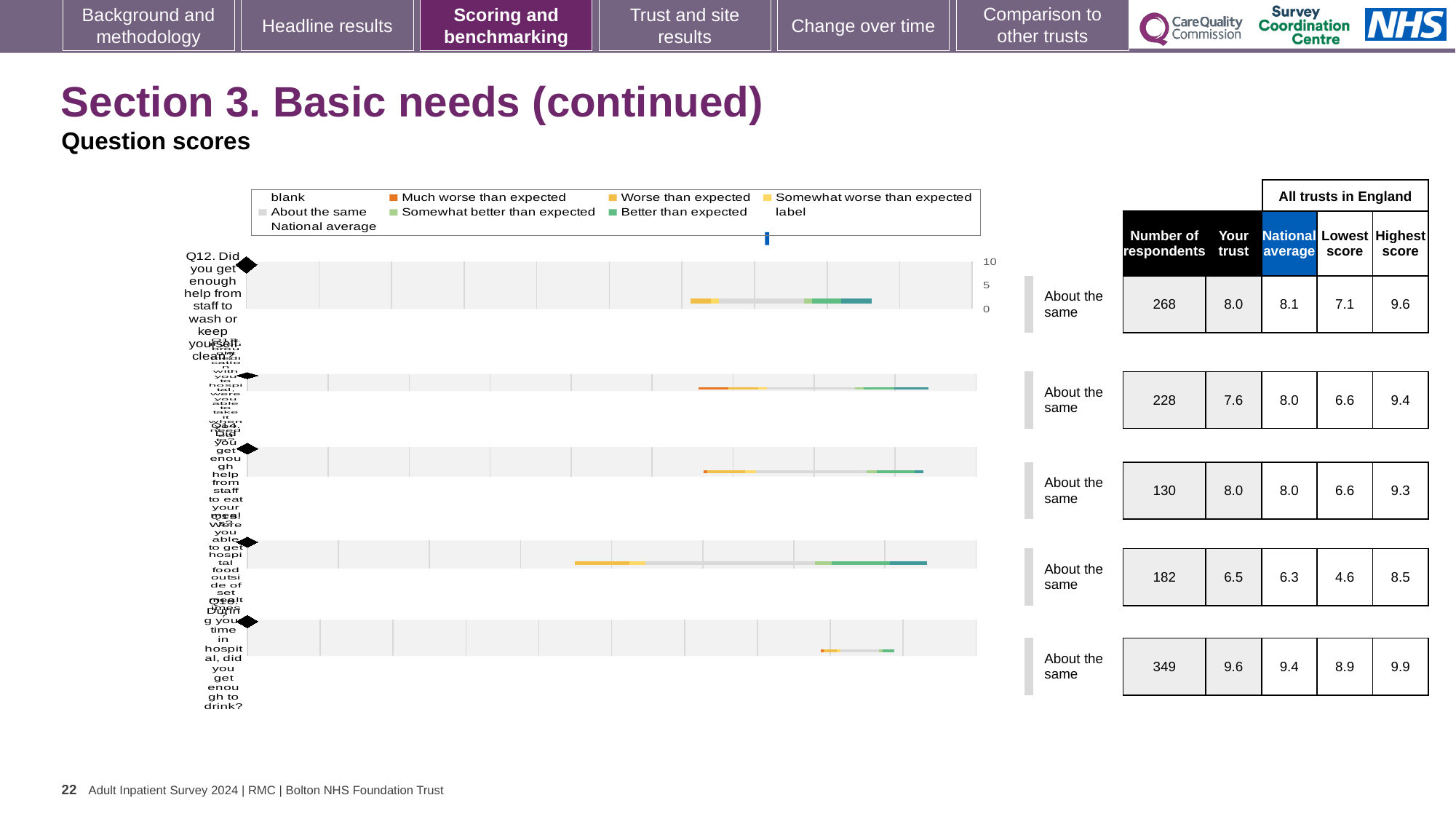
What is the lowest 'Your trust' score shown in the table? 6.5 How many respondents are listed for Q12 (enough help from staff to wash or keep yourself clean)? 268 For Q12, which is larger: the 'Your trust' score or the 'National average'? National average How many respondents are listed for Q16 (did you get enough to drink)? 349 What benchmark category is shown for every question row on this slide? About the same What kind of chart is used to show the question scores on this slide? bar chart How many question rows are plotted in the chart? 5 What is the 'Your trust' score for Q12 (enough help from staff to wash or keep yourself clean)? 8.0 What is the 'Your trust' score for Q16 (did you get enough to drink during your time in hospital)? 9.6 What colour does the legend use for 'Much worse than expected'? orange Which question row has the highest 'Your trust' score? Q16 (did you get enough to drink) For Q12, what is the difference between the highest score (9.6) and the lowest score (7.1) across all trusts in England? 2.5